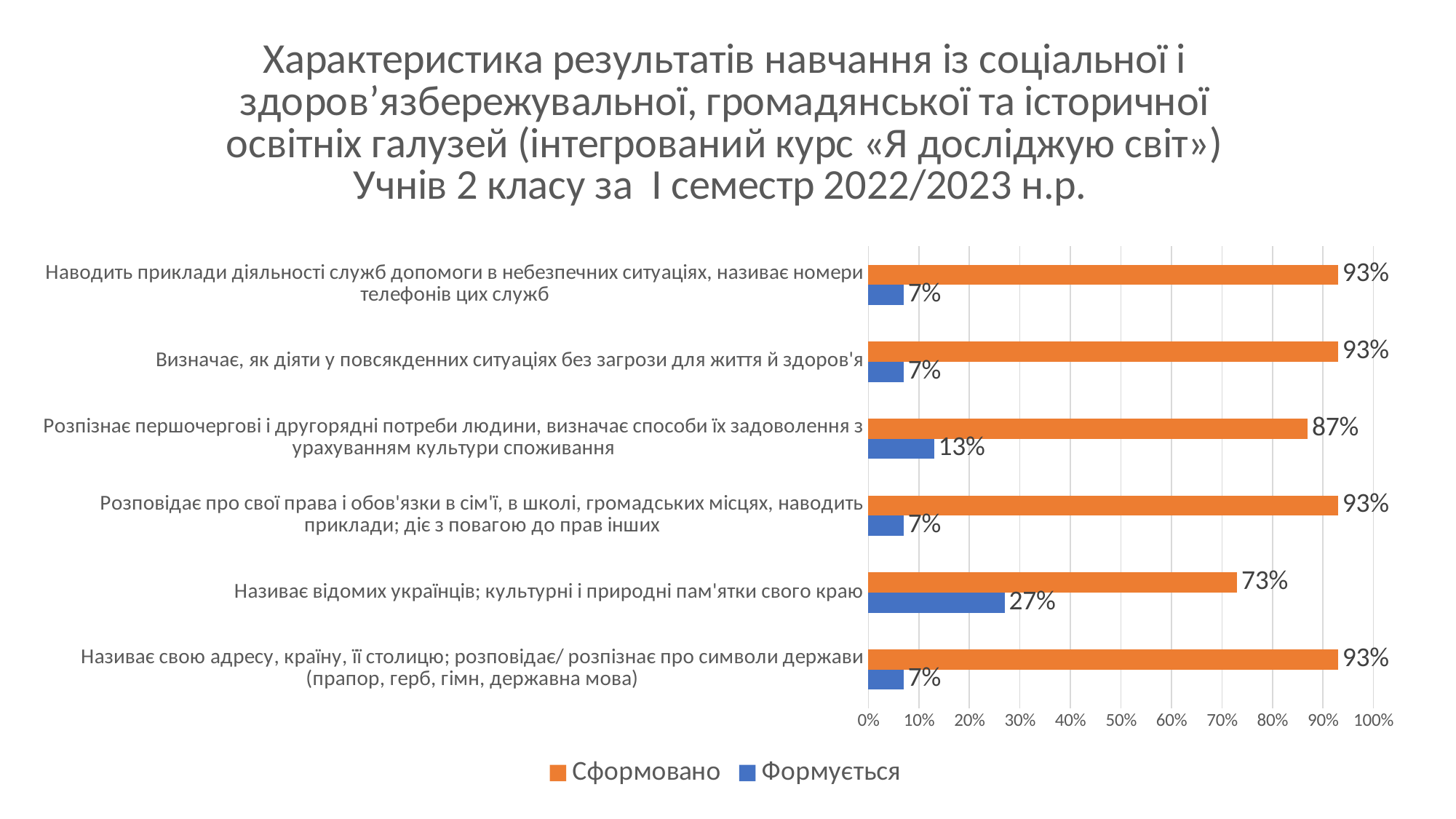
Which is larger: the Сформовано value for "Розпізнає першочергові і другорядні потреби людини..." or for "Визначає, як діяти у повсякденних ситуаціях без загрози для життя й здоров'я"? Визначає, як діяти у повсякденних ситуаціях без загрози для життя й здоров'я Which category has the lowest Сформовано value? Називає відомих українців; культурні і природні пам'ятки свого краю Which colour represents the Формується series? blue How many categories are plotted on the chart? 6 What is the total of Сформовано and Формується for "Розпізнає першочергові і другорядні потреби людини..."? 100% What is the value of Сформовано for "Називає відомих українців; культурні і природні пам'ятки свого краю"? 73% What type of chart is shown on the slide? bar chart What is the difference between the Сформовано and Формується values for "Називає відомих українців; культурні і природні пам'ятки свого краю"? 46% How many series does the legend list? 2 Which category has the highest Формується value? Називає відомих українців; культурні і природні пам'ятки свого краю What is the value of Формується for "Називає свою адресу, країну, її столицю; розповідає/ розпізнає про символи держави (прапор, герб, гімн, державна мова)"? 7% What is the value of Формується for "Розпізнає першочергові і другорядні потреби людини, визначає способи їх задоволення з урахуванням культури споживання"? 13%